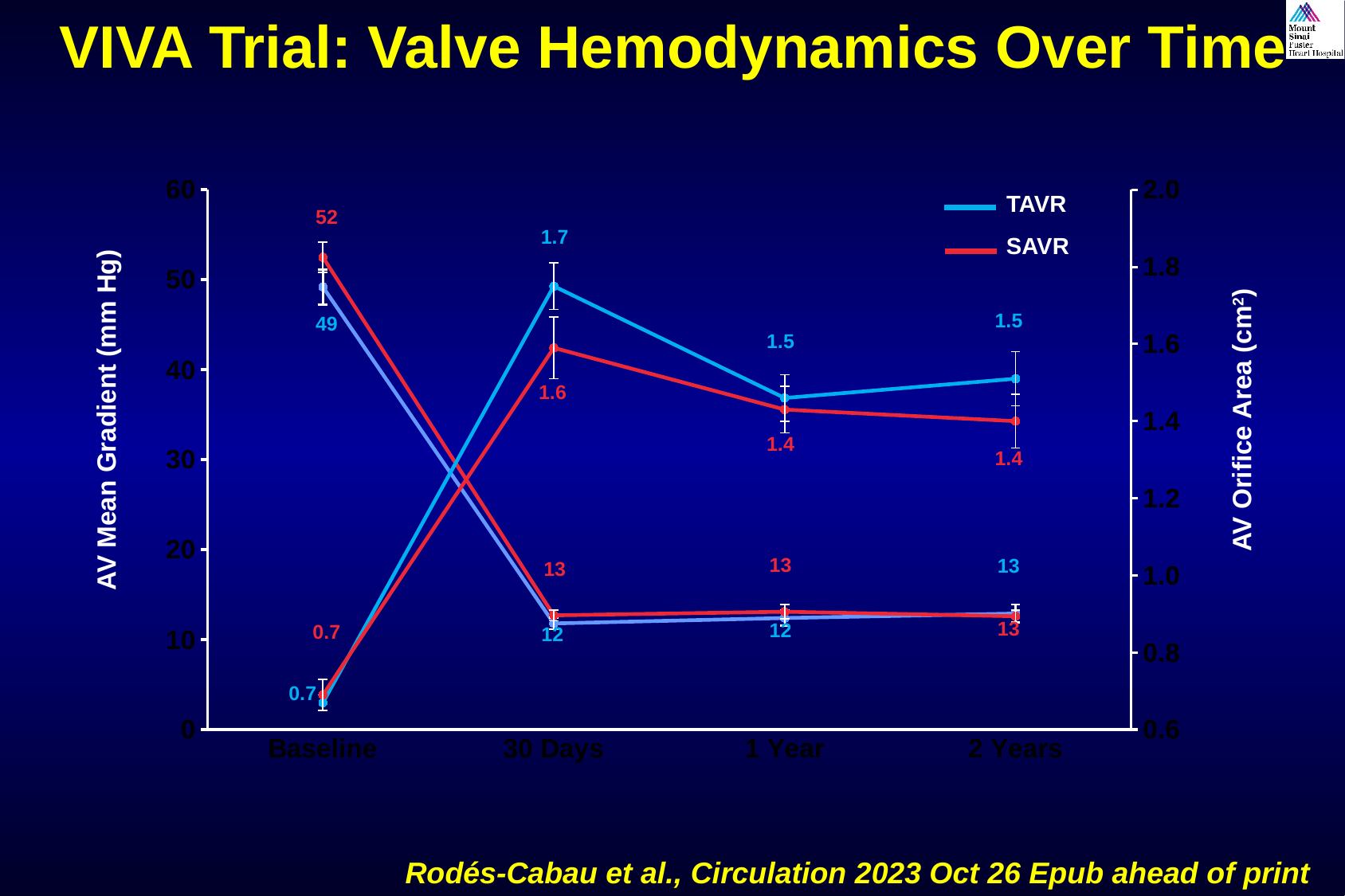
What is the difference between the SAVR and TAVR AV mean gradients at Baseline? 3 What is the TAVR AV orifice area at 30 Days? 1.7 At which time point is the TAVR AV orifice area highest? 30 Days What is the TAVR AV mean gradient at Baseline? 49 At 30 Days, which group has the larger AV orifice area, TAVR or SAVR? TAVR What is the SAVR AV mean gradient at Baseline? 52 What type of chart is shown on the slide? Line chart How many time points are plotted on the x axis? 4 What is the SAVR AV orifice area at 2 Years? 1.4 How many series does the legend list? 2 What is the TAVR AV mean gradient at 1 Year? 12 What is the label of the right-hand y axis? AV Orifice Area (cm²)